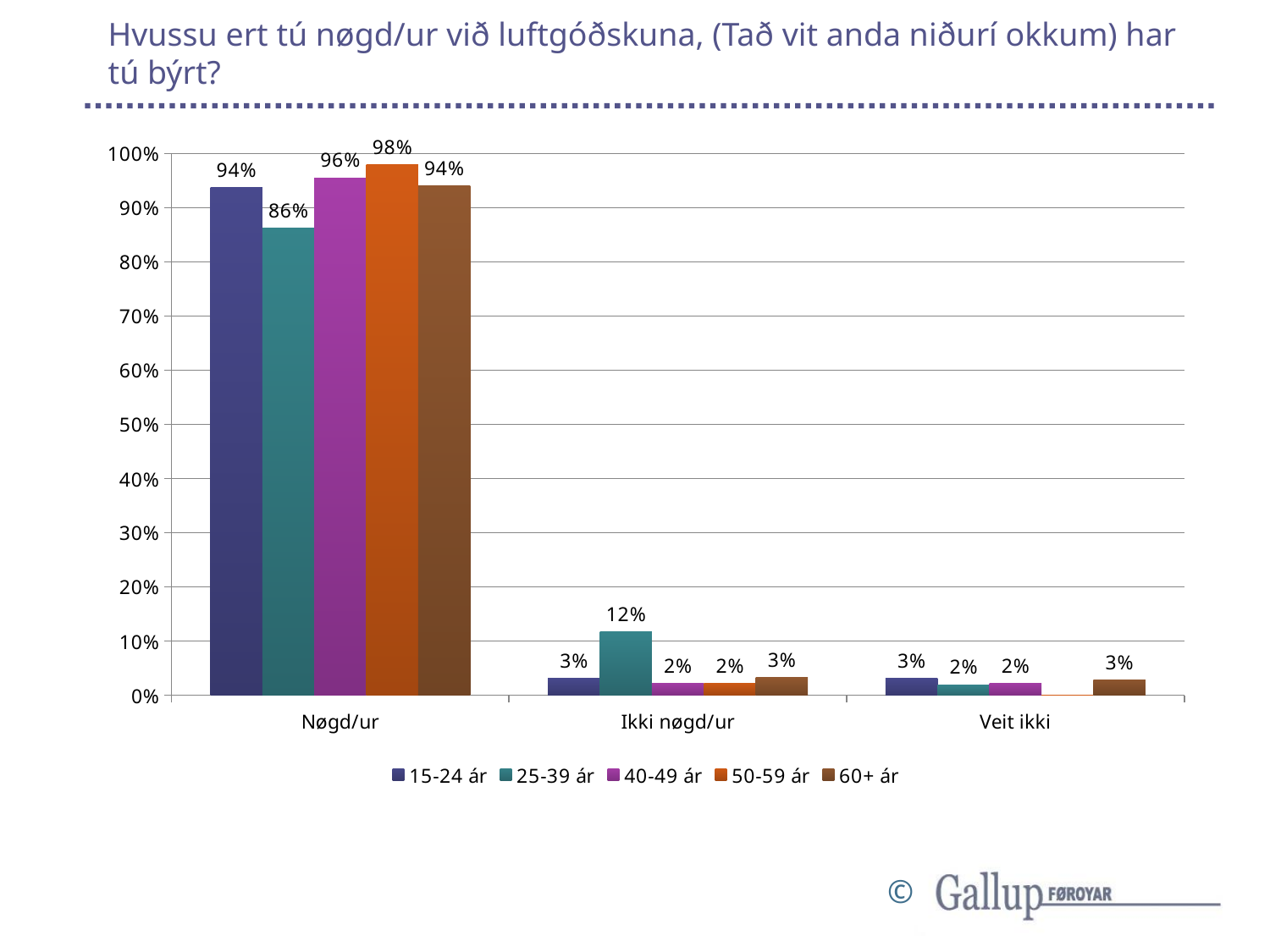
What is the value for the 25-39 ár series in the Ikki nøgd/ur category? 12% What is the difference between the 50-59 ár and 25-39 ár values in the Nøgd/ur category? 12% How many categories are shown on the x axis? 3 Is the value for 25-39 ár in the Nøgd/ur category greater or less than 90%? less What is the value for the 50-59 ár series in the Nøgd/ur category? 98% Which series is shown in orange in the legend? 50-59 ár How many series does the legend list? 5 What kind of chart is shown on the slide? bar chart Which age group has the lowest value in the Nøgd/ur category? 25-39 ár What is the value for the 15-24 ár series in the Veit ikki category? 3% Which age group has the highest value in the Nøgd/ur category? 50-59 ár In the Ikki nøgd/ur category, which is larger: the value for 25-39 ár or the value for 60+ ár? 25-39 ár